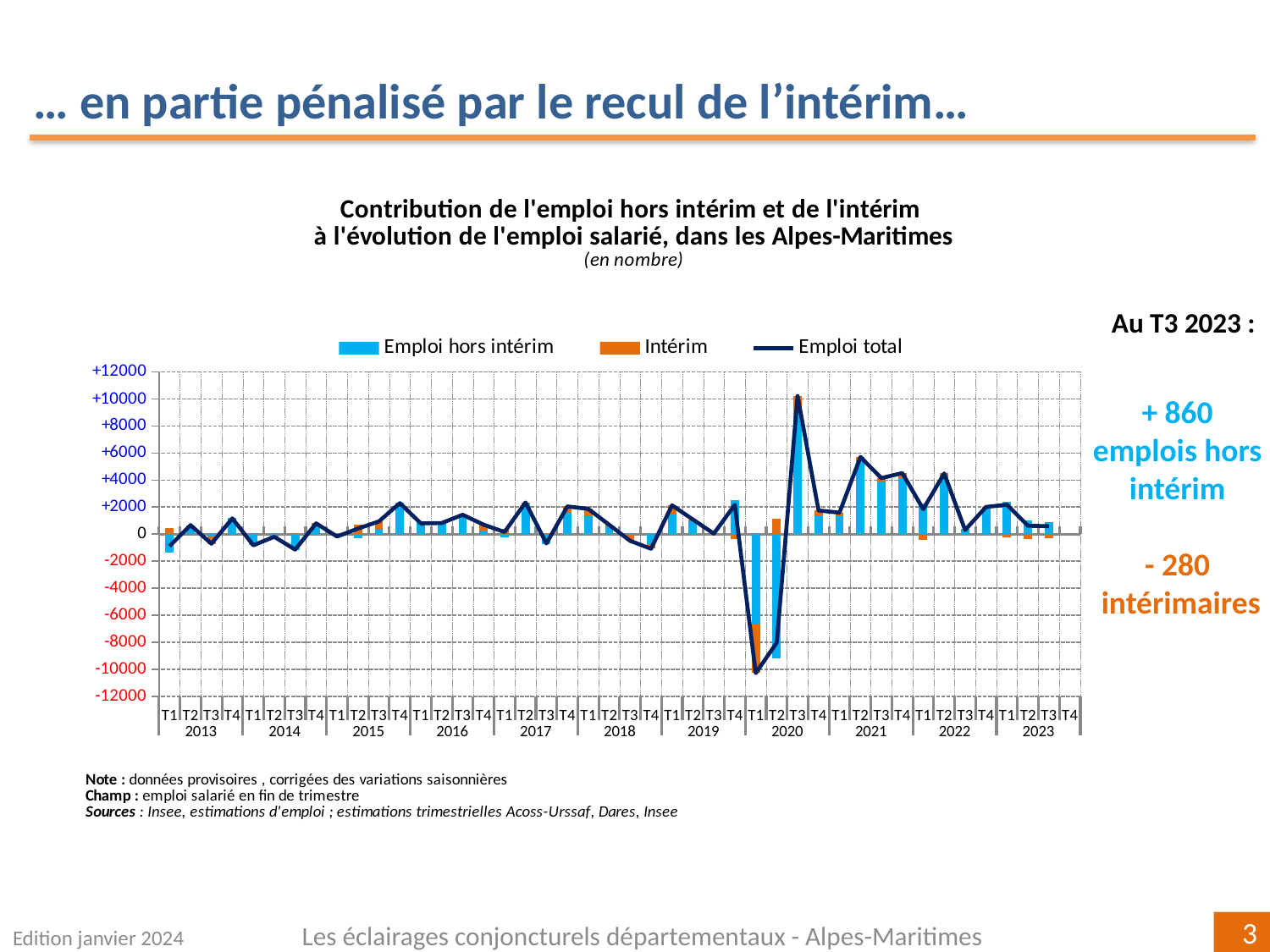
What kind of chart is shown on the slide? A bar chart combined with a line chart In which quarter does the Emploi total line reach its highest value? T3 2020 How many years are labelled on the x axis of the chart? 11 According to the slide, what is the value for Emploi hors intérim at T3 2023? + 860 Which is larger, the Emploi total value at T2 2021 or at T2 2022? T2 2021 What is the title of the chart? Contribution de l'emploi hors intérim et de l'intérim à l'évolution de l'emploi salarié, dans les Alpes-Maritimes How many series does the chart legend list? 3 In which quarter does the Emploi total line reach its lowest value? T1 2020 Is the value of Emploi total at T2 2021 greater or less than +4000? greater Does the Emploi total line rise or fall between T3 2020 and T4 2020? fall Is the value of Emploi total at T3 2020 greater or less than +8000? greater According to the slide, what is the value for Intérim at T3 2023? - 280